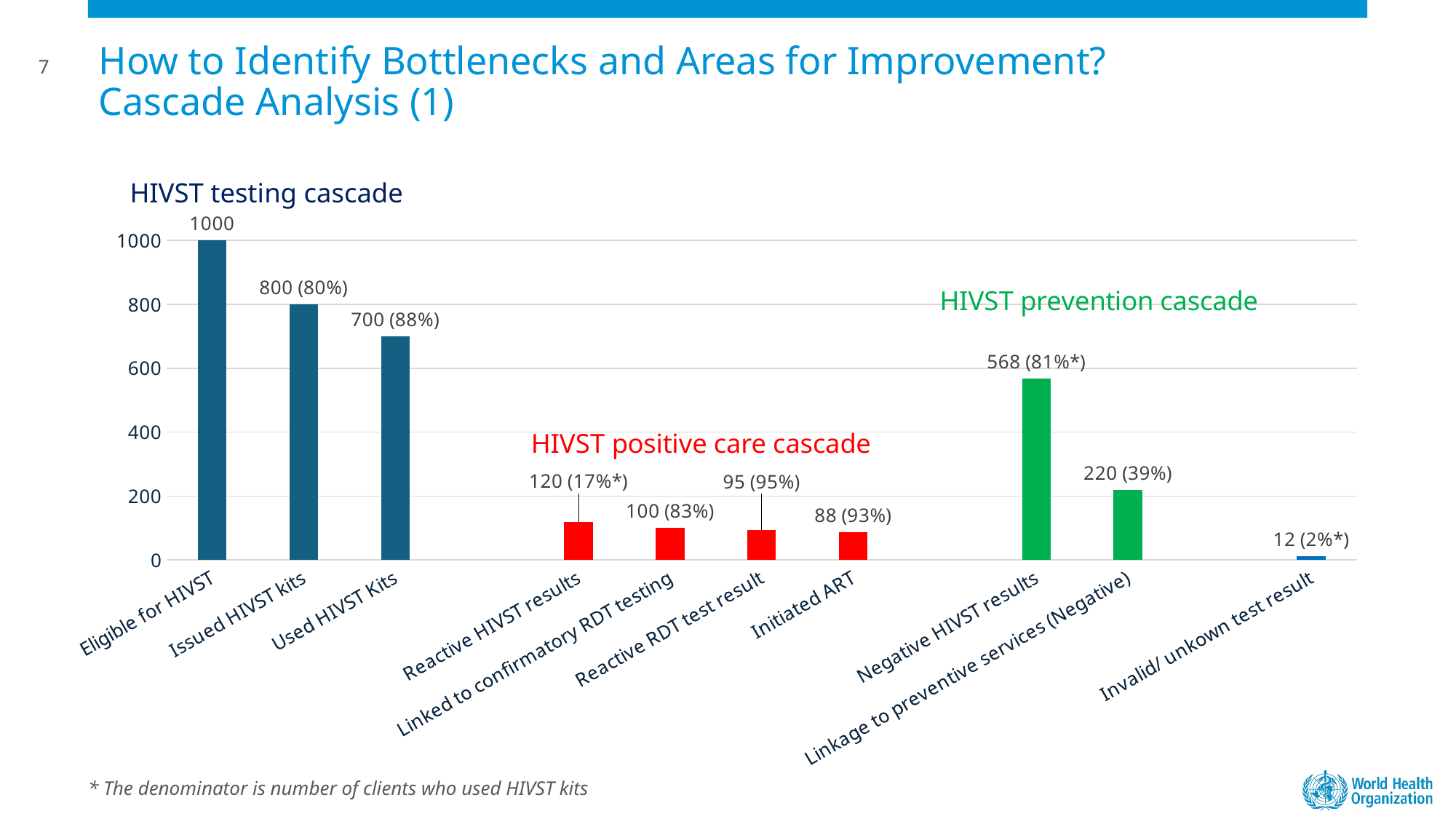
What is the value for Eligible for HIVST? 1000 What is the data label shown for Negative HIVST results? 568 (81%*) Which category has the lowest value? Invalid/ unkown test result What kind of chart is shown on the slide? Bar chart What is the data label shown for Issued HIVST kits? 800 (80%) What is the data label shown for Initiated ART? 88 (93%) What is the data label shown for Reactive HIVST results? 120 (17%*) What is the difference between the number Issued HIVST kits and the number who Used HIVST Kits? 100 How many categories are shown on the x axis? 10 Which category has the highest value? Eligible for HIVST What is the data label shown for Used HIVST Kits? 700 (88%) Which is larger, the value for Linked to confirmatory RDT testing or the value for Reactive RDT test result? Linked to confirmatory RDT testing